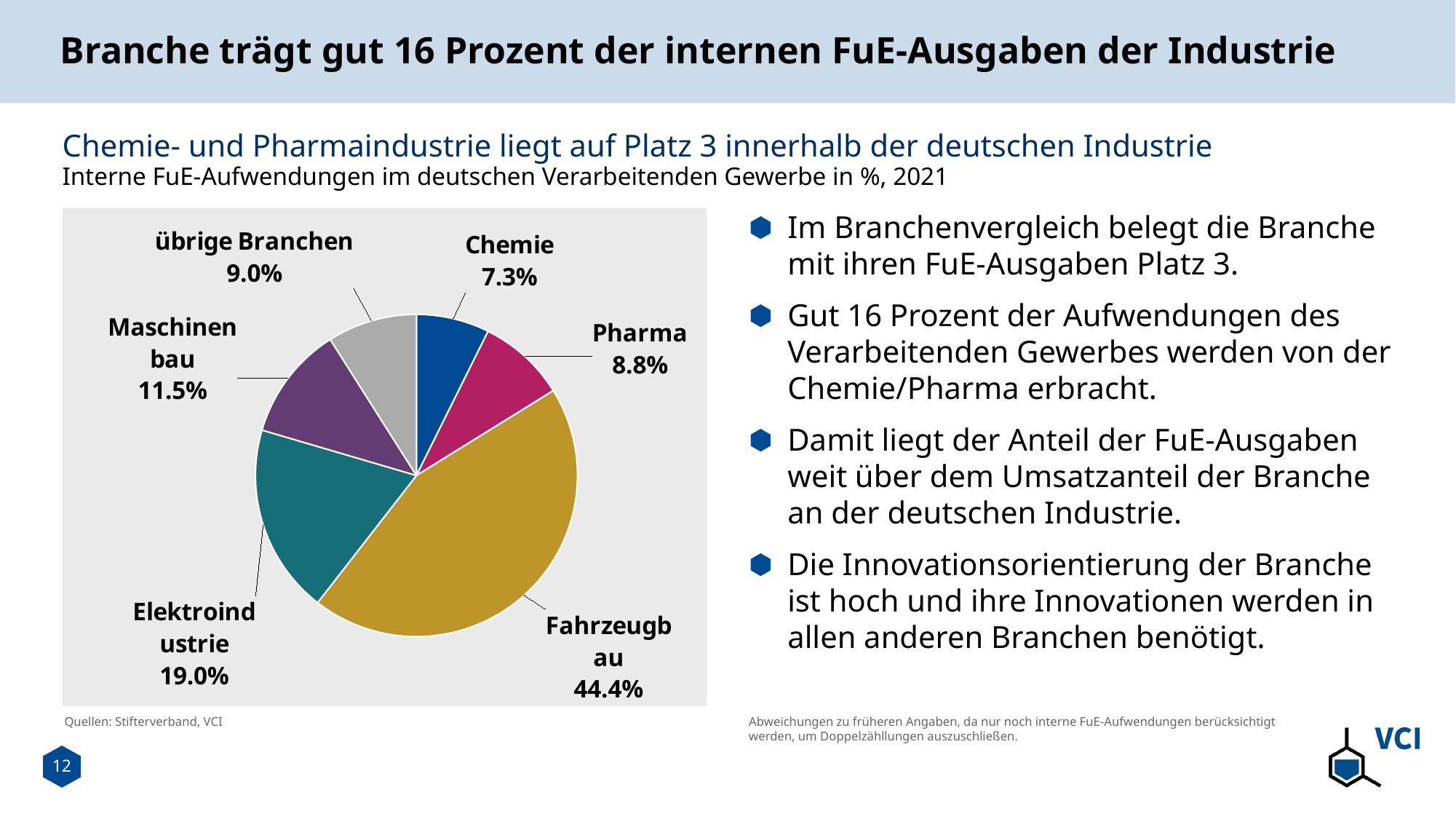
What is the value shown for Maschinenbau? 11.5% How many categories are shown in the pie chart? 6 Which is larger, the share of Maschinenbau or the share of übrige Branchen? Maschinenbau Which category has the largest slice of the pie? Fahrzeugbau What colour is the Fahrzeugbau slice? Gold/yellow What is the difference between the shares of Pharma and Chemie? 1.5% What is the value shown for Chemie? 7.3% What share of the pie does Fahrzeugbau hold? 44.4% Which category has the smallest slice of the pie? Chemie What is the combined share of Chemie and Pharma? 16.1% What kind of chart is shown on the slide? Pie chart What is the value shown for Elektroindustrie? 19.0%